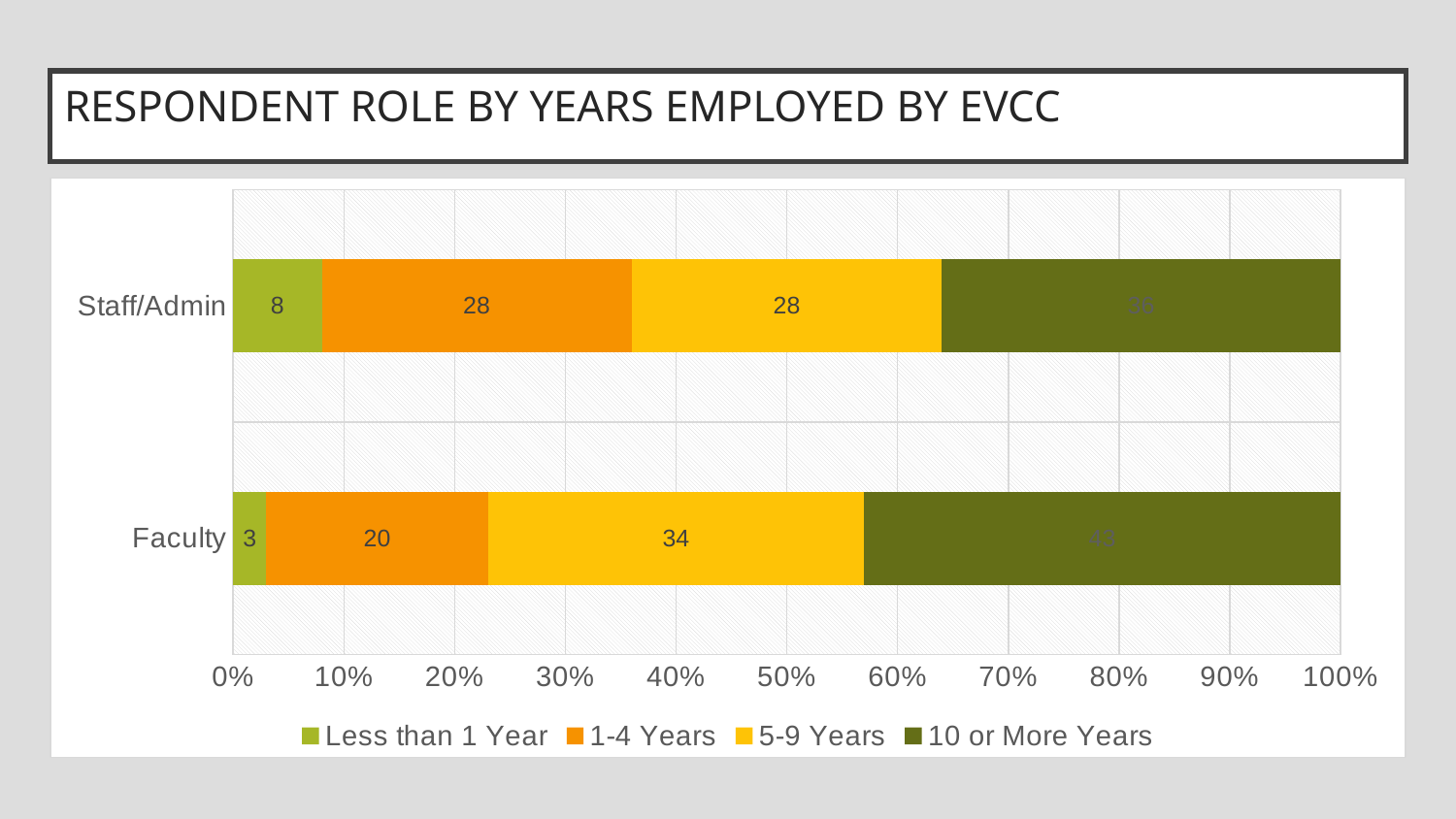
What is the difference between the Less than 1 Year values for Staff/Admin and Faculty? 5 What is the value for 1-4 Years for Faculty? 20 Which series has the largest segment in the Faculty bar? 10 or More Years What is the value for 5-9 Years for Staff/Admin? 28 How many roles (categories) are shown on the chart? 2 How many series does the legend list? 4 What is the value for 5-9 Years for Faculty? 34 Which role has the larger value for 5-9 Years, Staff/Admin or Faculty? Faculty Which series has the smallest segment in the Staff/Admin bar? Less than 1 Year What is the value for Less than 1 Year for Staff/Admin? 8 What is the difference between the 1-4 Years values for Staff/Admin and Faculty? 8 What kind of chart is shown on the slide? Stacked bar chart